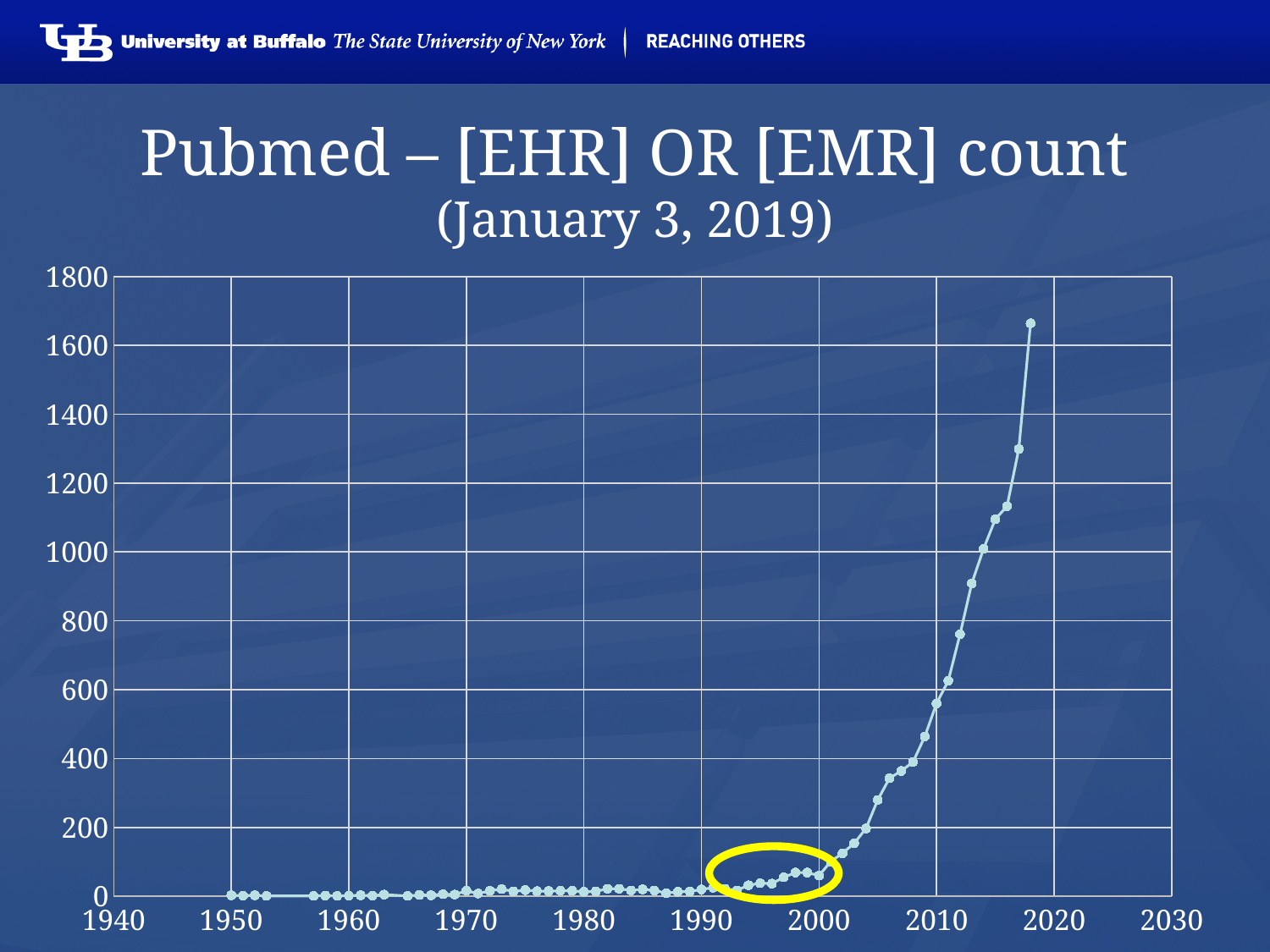
Is the value for the year 2000 greater or less than 200? less What is the title of the chart? Pubmed – [EHR] OR [EMR] count Is the highest plotted point greater or less than 1600? greater Is the value for the year 2010 greater or less than 800? less Do the plotted values rise or fall as the years increase along the x axis? rise Which year has the larger value, 2000 or 2010? 2010 What date is given in the chart's subtitle? January 3, 2019 What kind of chart is shown on the slide? line chart Which year has the larger value, 1980 or 2000? 2000